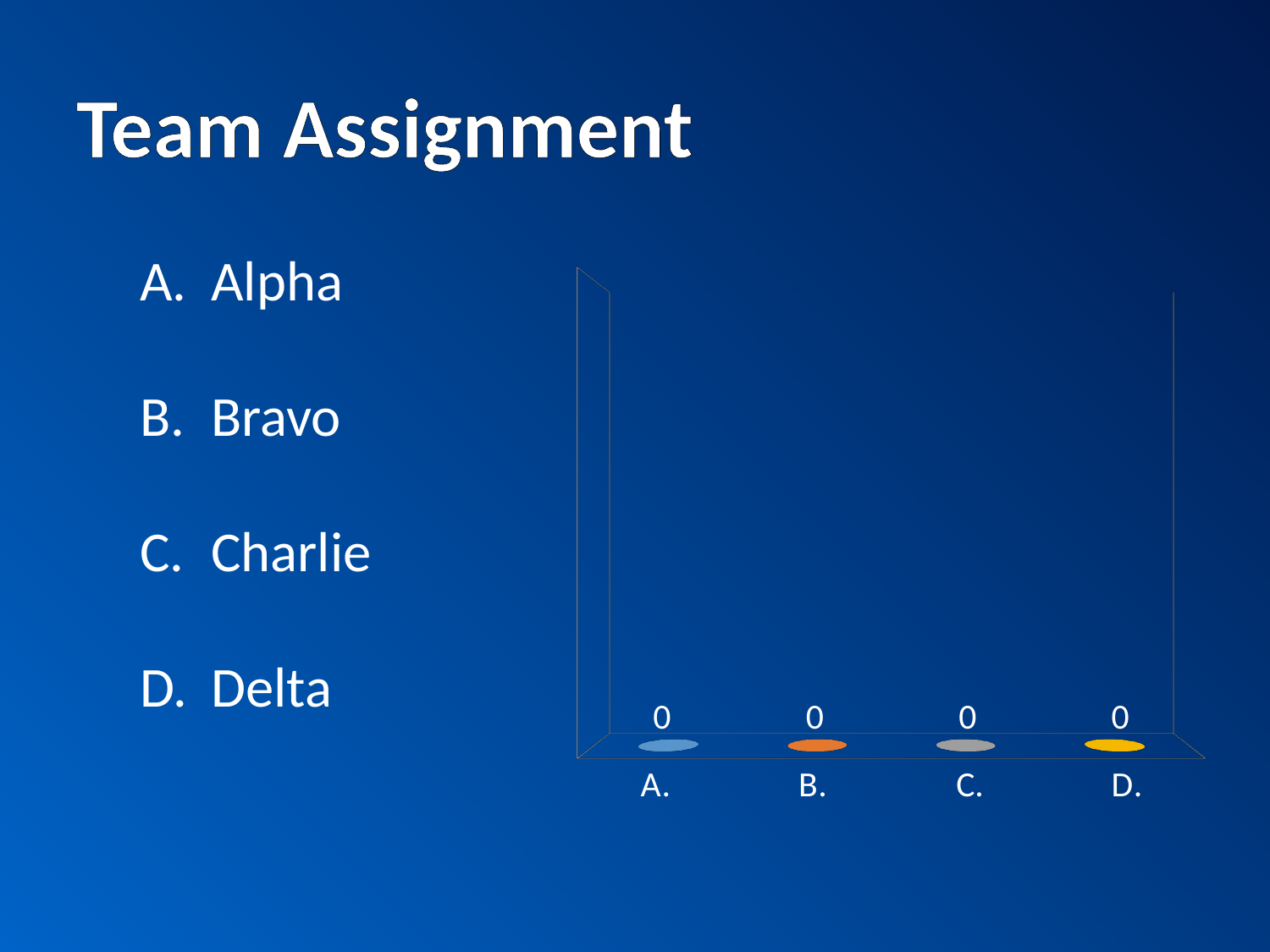
What is the value shown for category C. in the chart? 0 What colour is the bar for category B.? Orange What is the value shown for category D. in the chart? 0 What are the category labels along the x axis of the chart? A., B., C., D. What is the value shown for category B. in the chart? 0 What is the difference between the values for A. and D.? 0 How many categories are plotted on the chart's x axis? 4 What kind of chart is shown on the slide? Bar chart What is the value shown for category A. in the chart? 0 Do the values rise, fall, or stay the same from A. to D.? Stay the same